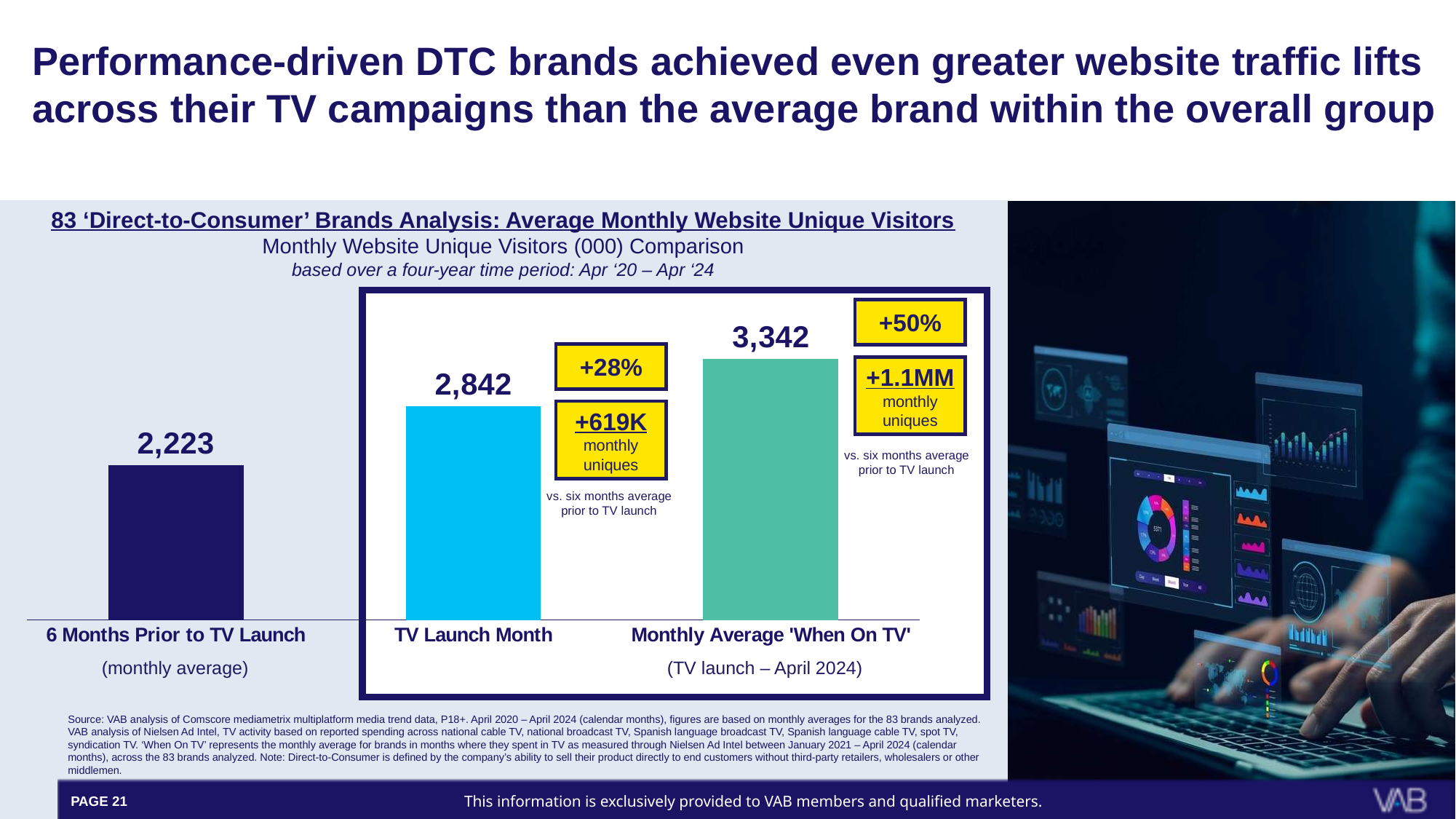
How many bars are shown in the chart? 3 Do the values rise or fall from left to right across the categories? Rise What kind of chart is shown on the slide? Bar chart Which category has the lowest value? 6 Months Prior to TV Launch What is the difference between the 'Monthly Average 'When On TV'' value and the '6 Months Prior to TV Launch' value? 1,119 What percentage lift is shown for the 'Monthly Average 'When On TV'' bar versus the six months prior to TV launch? +50% Which category has the highest value? Monthly Average 'When On TV' What is the value for 'TV Launch Month'? 2,842 What is the value for 'Monthly Average 'When On TV''? 3,342 Which is larger, the value for 'TV Launch Month' or the value for 'Monthly Average 'When On TV''? Monthly Average 'When On TV' What is the difference between the 'TV Launch Month' value and the '6 Months Prior to TV Launch' value? 619 What is the value for '6 Months Prior to TV Launch'? 2,223